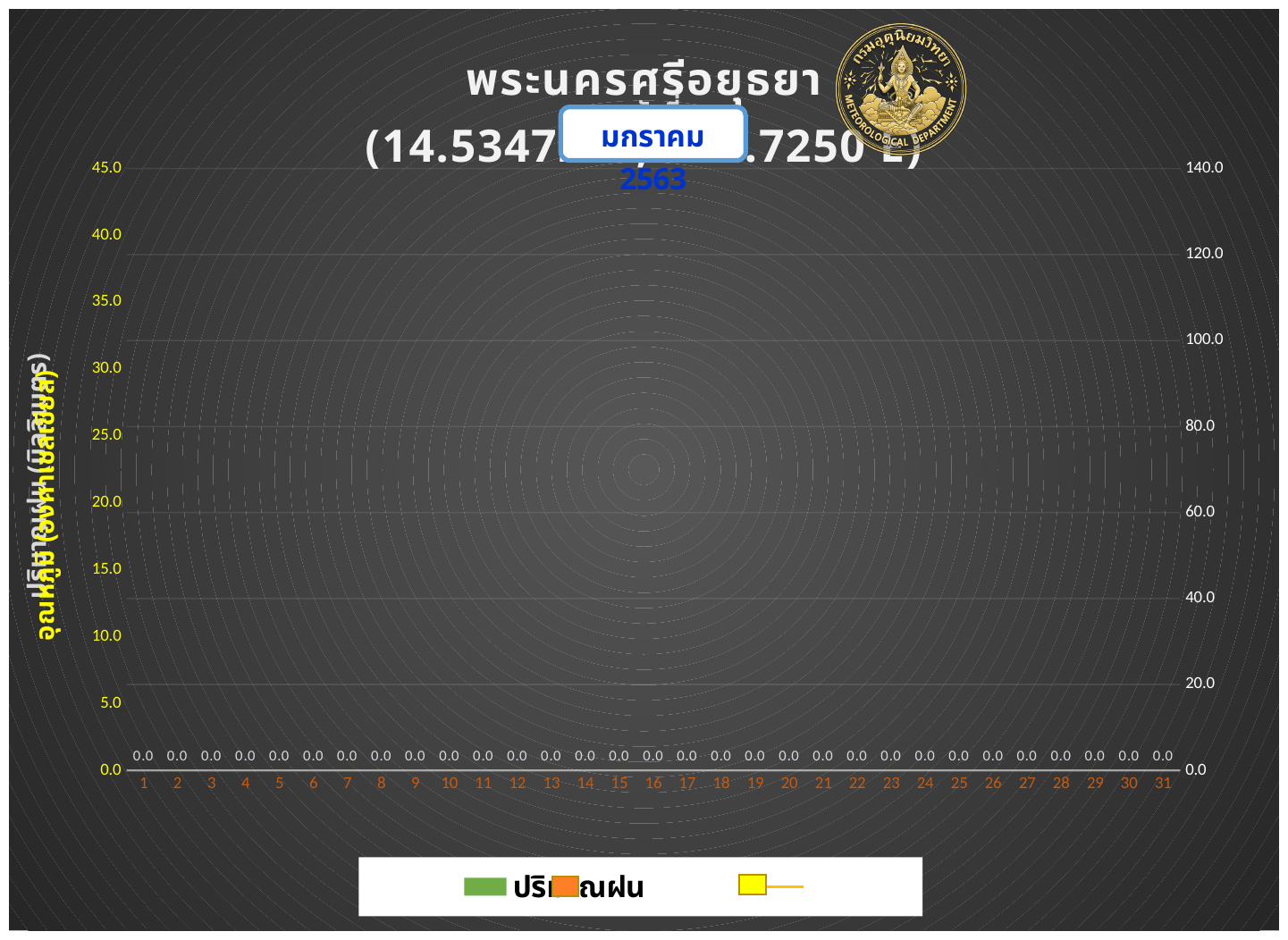
What is the difference between the values for day 3 and day 20? 0.0 How many days (categories) are shown along the x axis? 31 What is the data label value for day 1? 0.0 What year is shown below the month label in the chart title area? 2563 Is the value for day 10 greater or less than 5.0? less What is the highest tick value shown on the left vertical axis? 45.0 What is the highest tick value shown on the right vertical axis? 140.0 Do the data label values rise, fall, or stay the same from day 1 to day 31? stay the same What is the data label value for day 15? 0.0 What is the data label value for day 31? 0.0